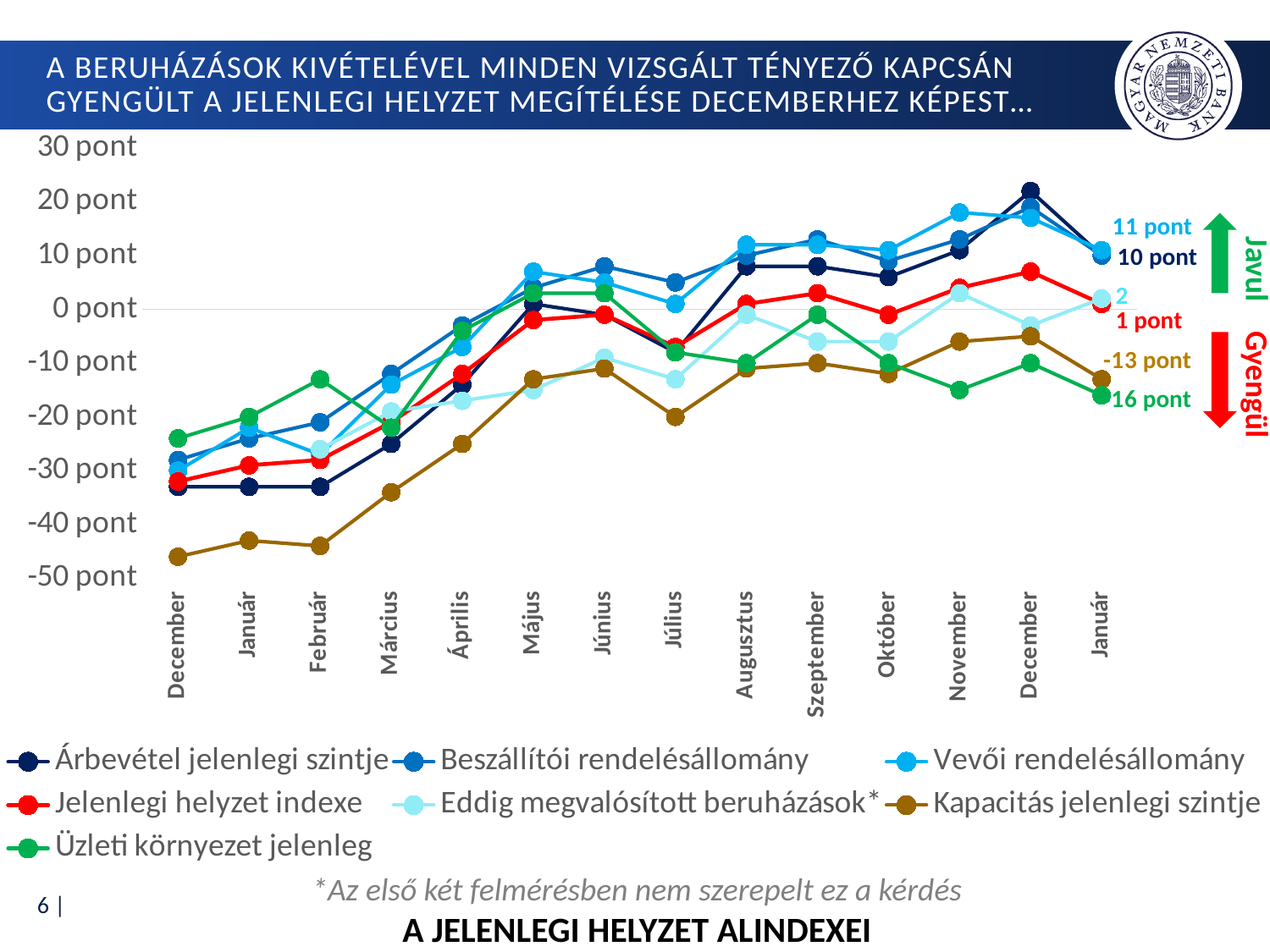
What is the value of Kapacitás jelenlegi szintje in the final January? -13 pont What is the value of Árbevétel jelenlegi szintje in the final January? 10 pont How many series does the legend list? 7 Which series has the lowest value in the first December? Kapacitás jelenlegi szintje Is the value for Árbevétel jelenlegi szintje in the second December greater or less than 10 pont? greater What is the value of Vevői rendelésállomány in the final January? 11 pont How many months are shown along the x axis? 14 What is the value of Jelenlegi helyzet indexe in the final January? 1 pont In the final January, what is the difference between Vevői rendelésállomány and Kapacitás jelenlegi szintje? 24 pont Is the value for Kapacitás jelenlegi szintje in the first December greater or less than -40 pont? less Does Kapacitás jelenlegi szintje rise or fall from the first December to May? rise What kind of chart is shown on the slide? line chart